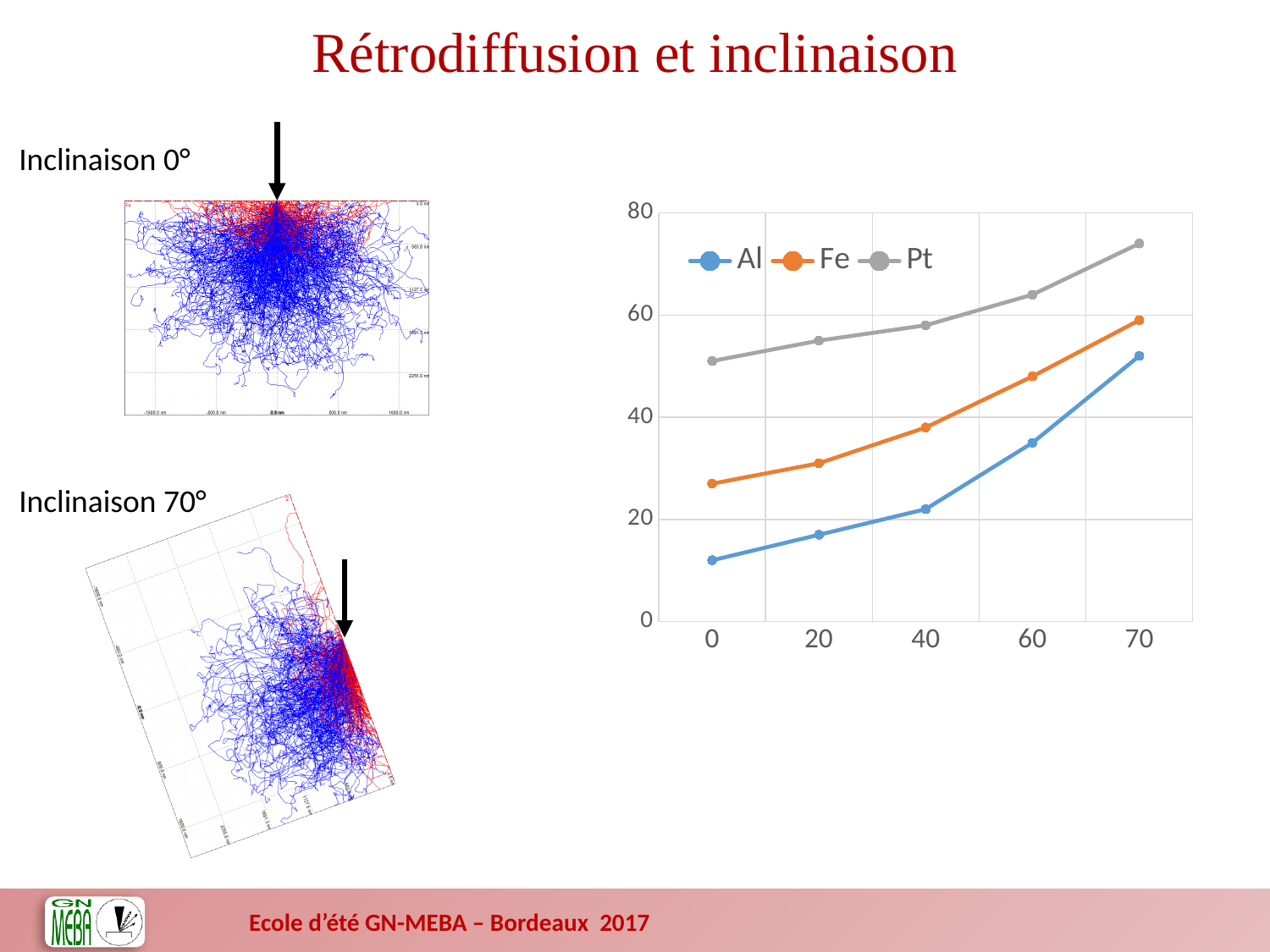
Is the value for Al at x = 0 greater or less than 20? less Which series has the lowest value at x = 0? Al How many x-axis points are plotted for each series in the chart? 5 Which series are listed in the chart legend? Al, Fe, Pt At x = 70, which is larger, the value for Fe or the value for Al? Fe Is the value for Fe at x = 0 greater or less than 20? greater Do the values for Pt rise or fall as the x axis goes from 0 to 70? rise Is the value for Pt at x = 70 greater or less than 60? greater What kind of chart is shown on the slide? line chart Which series has the highest value at x = 70? Pt How many series does the chart legend list? 3